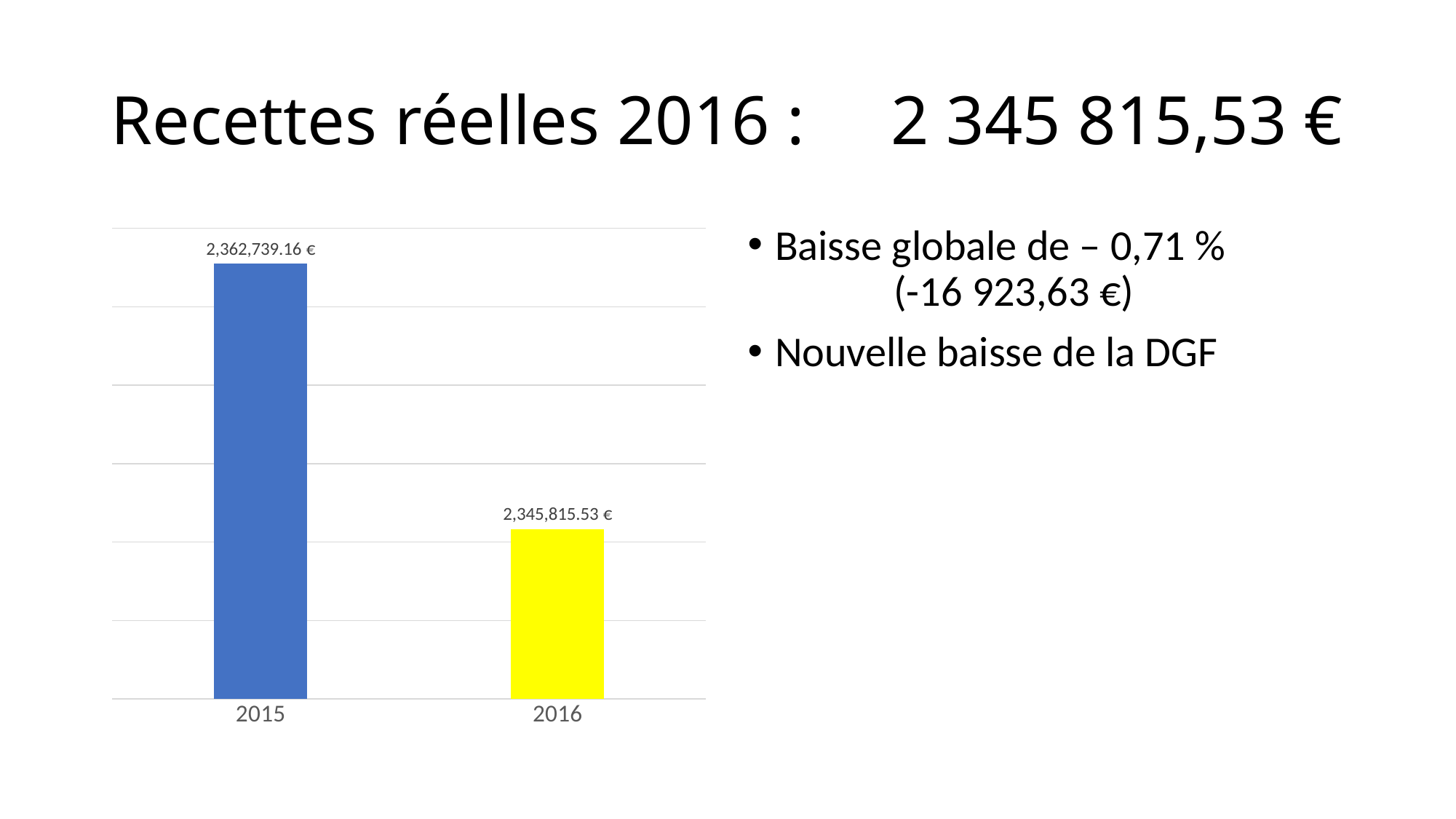
Which year has the higher value? 2015 Is the value for 2016 larger or smaller than the value for 2015? smaller What is the value shown for 2016? 2,345,815.53 € What is the value shown for 2015? 2,362,739.16 € What colour is the bar for 2016? yellow What colour is the bar for 2015? blue Do the values rise or fall from 2015 to 2016? fall What kind of chart is shown on the slide? bar chart What is the difference between the 2015 value and the 2016 value? 16,923.63 € Which year has the lower value? 2016 How many categories are plotted on the chart? 2